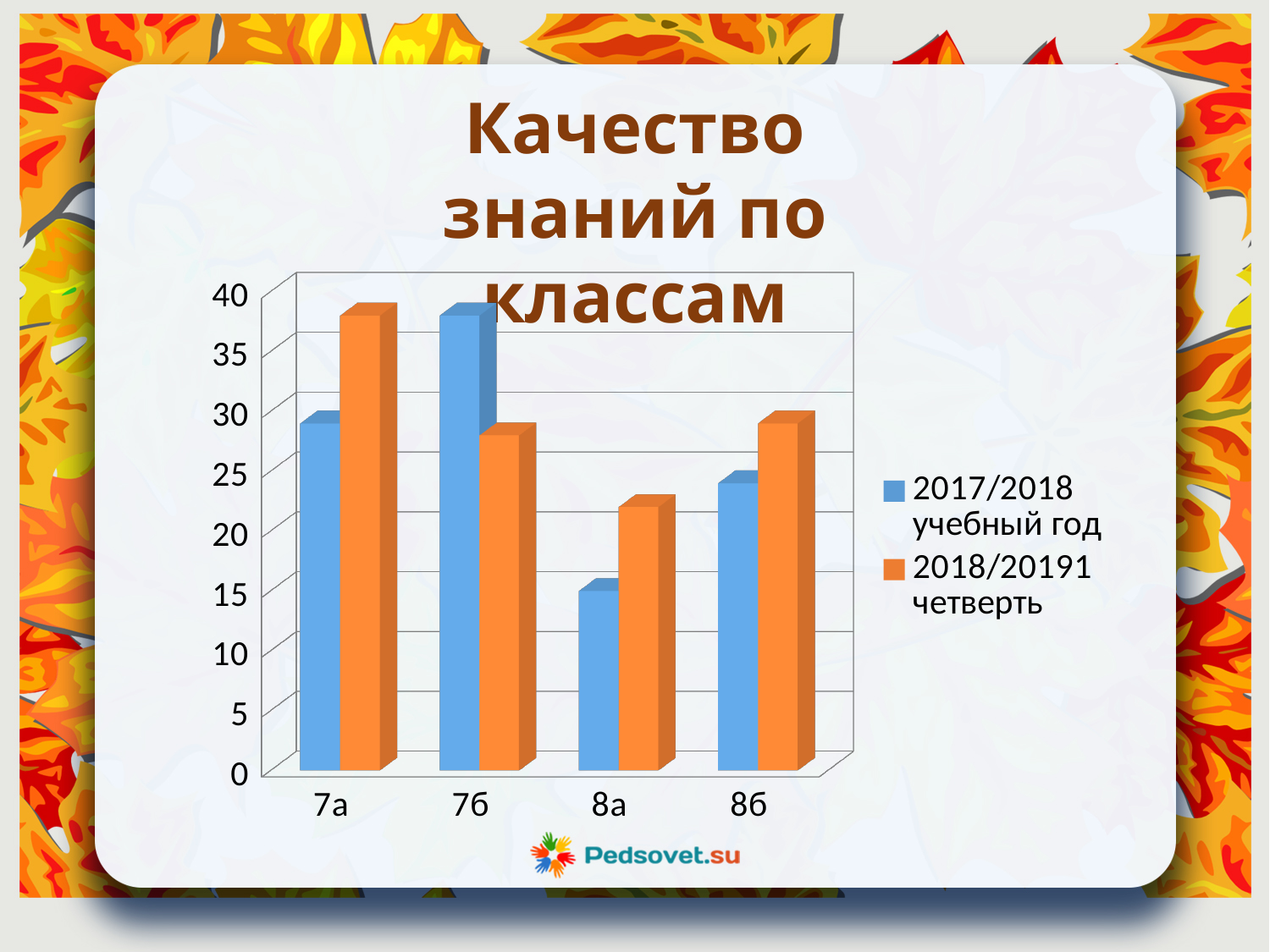
Is the value for 8а in the 2017/2018 учебный год series greater or less than 20? less Which class has the highest value for the 2017/2018 учебный год series? 7б Which class has the highest value for the 2018/2019 1 четверть series? 7а Which class has the lowest value for the 2018/2019 1 четверть series? 8а How many series does the chart legend list? 2 Is the value for 7а in the 2018/2019 1 четверть series greater or less than 35? greater What colour are the bars for the 2017/2018 учебный год series? blue What kind of chart is shown on the slide? bar chart For class 7б, which series has the larger value: 2017/2018 учебный год or 2018/2019 1 четверть? 2017/2018 учебный год Which class has the lowest value for the 2017/2018 учебный год series? 8а For class 8а, which series has the larger value: 2017/2018 учебный год or 2018/2019 1 четверть? 2018/2019 1 четверть How many classes (categories) are shown on the x axis of the chart? 4